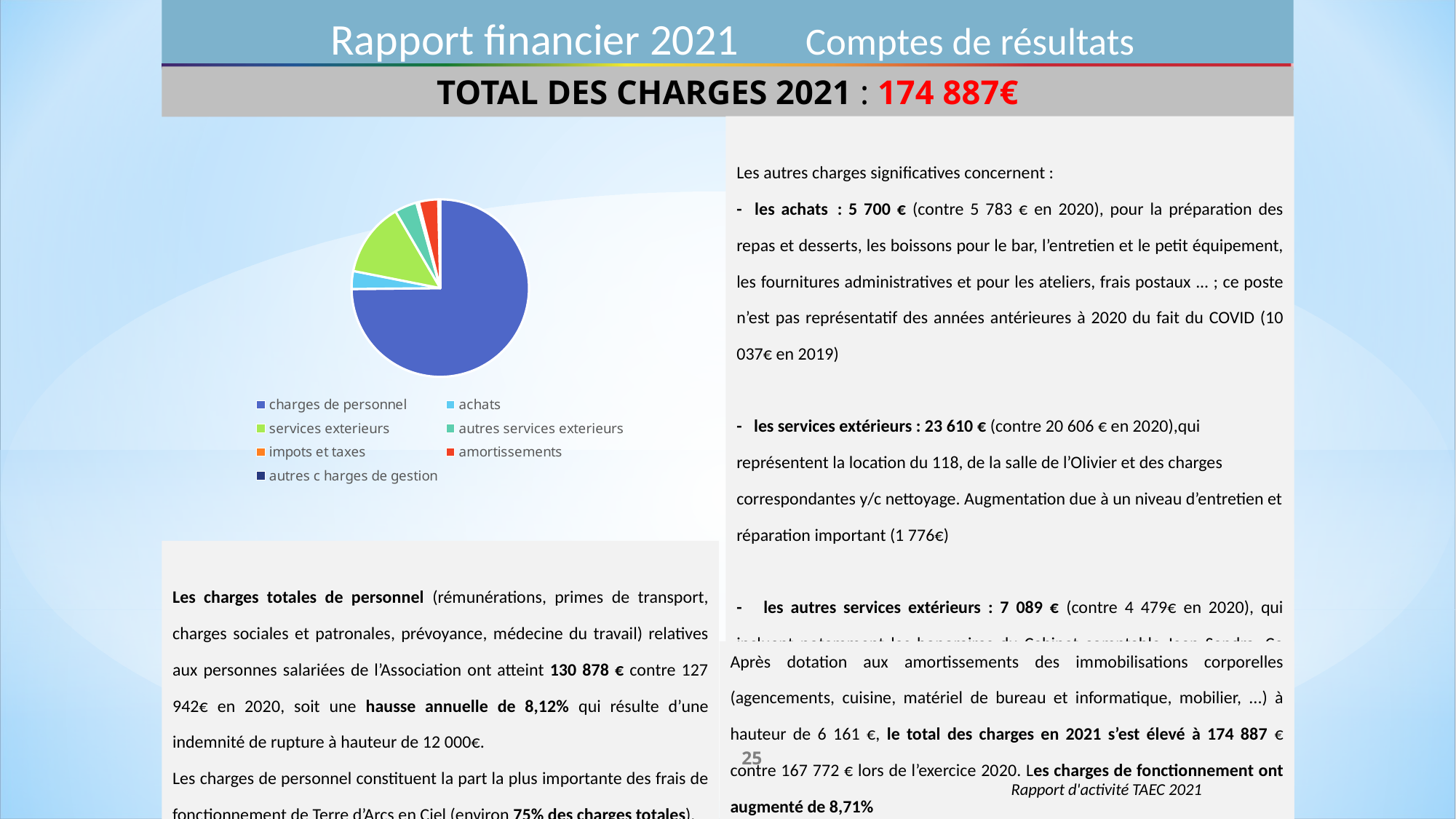
What colour is the services exterieurs slice in the pie chart? green Which is larger in the pie chart, services exterieurs or achats? services exterieurs Which is larger in the pie chart, charges de personnel or services exterieurs? charges de personnel What colour is the charges de personnel slice in the pie chart? blue Which is larger in the pie chart, charges de personnel or achats? charges de personnel How many categories does the legend of the pie chart list? 7 What kind of chart is shown on the slide? pie chart Which category has the largest slice of the pie chart? charges de personnel